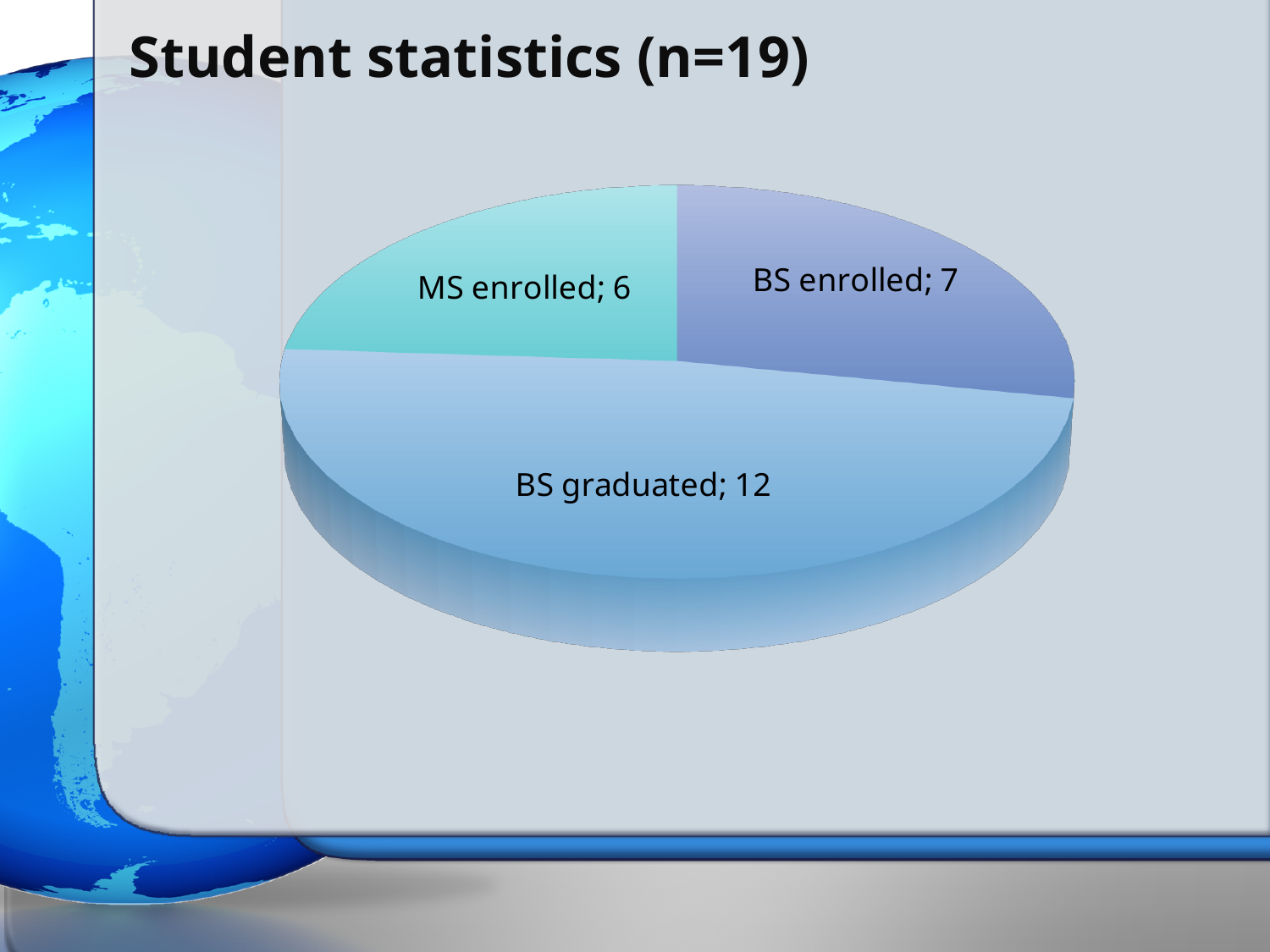
What value is shown for the MS enrolled slice? 6 Which slice of the pie chart is the smallest? MS enrolled What kind of chart is shown on the slide? Pie chart Which slice of the pie chart is the largest? BS graduated What value is shown for the BS enrolled slice? 7 How many slices does the pie chart have? 3 What is the difference between the BS graduated value and the BS enrolled value? 5 Which is larger, BS graduated or MS enrolled? BS graduated What value is shown for the BS graduated slice? 12 What is the difference between the BS enrolled value and the MS enrolled value? 1 What share of the pie does the BS graduated slice represent? 48% What is the title of the slide containing the chart? Student statistics (n=19)